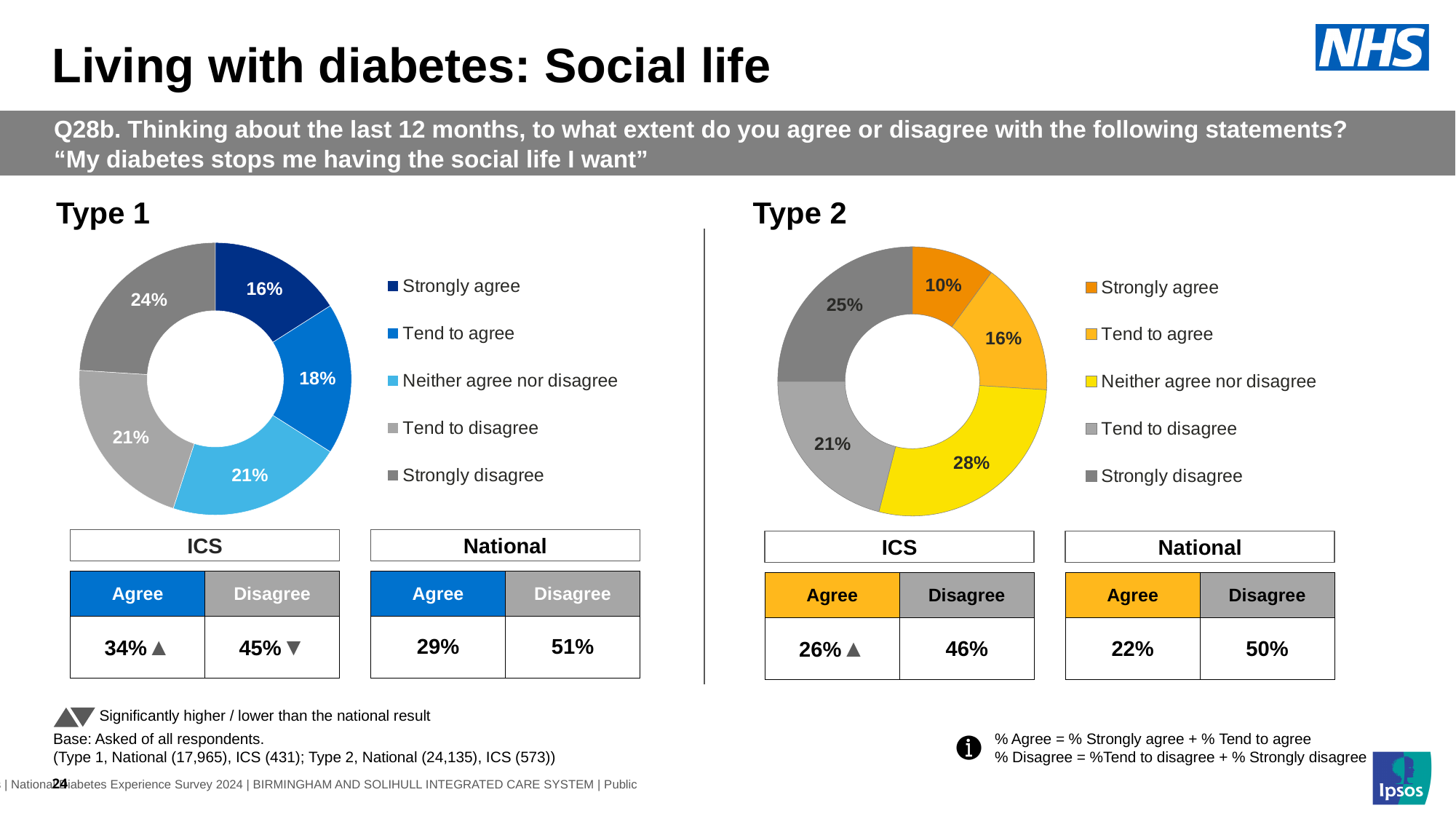
In the Type 2 chart, what percentage of respondents said 'Strongly disagree'? 25% In the Type 2 chart, what colour represents 'Neither agree nor disagree'? Yellow How many response categories does the legend of the Type 1 chart list? 5 In the Type 2 chart, which response category has the largest share? Neither agree nor disagree In the Type 2 chart, which response category has the smallest share? Strongly agree In the Type 1 chart, which response category has the largest share? Strongly disagree In the Type 2 chart, which is larger: 'Tend to agree' or 'Tend to disagree'? Tend to disagree What kind of chart is used to show the Type 2 results? Donut (pie) chart In the Type 1 chart, what percentage of respondents said 'Strongly agree'? 16% In the Type 1 chart, what is the difference in percentage points between 'Strongly disagree' and 'Strongly agree'? 8 In the Type 1 chart, what percentage of respondents said 'Tend to agree'? 18% In the Type 2 chart, what percentage of respondents said 'Neither agree nor disagree'? 28%